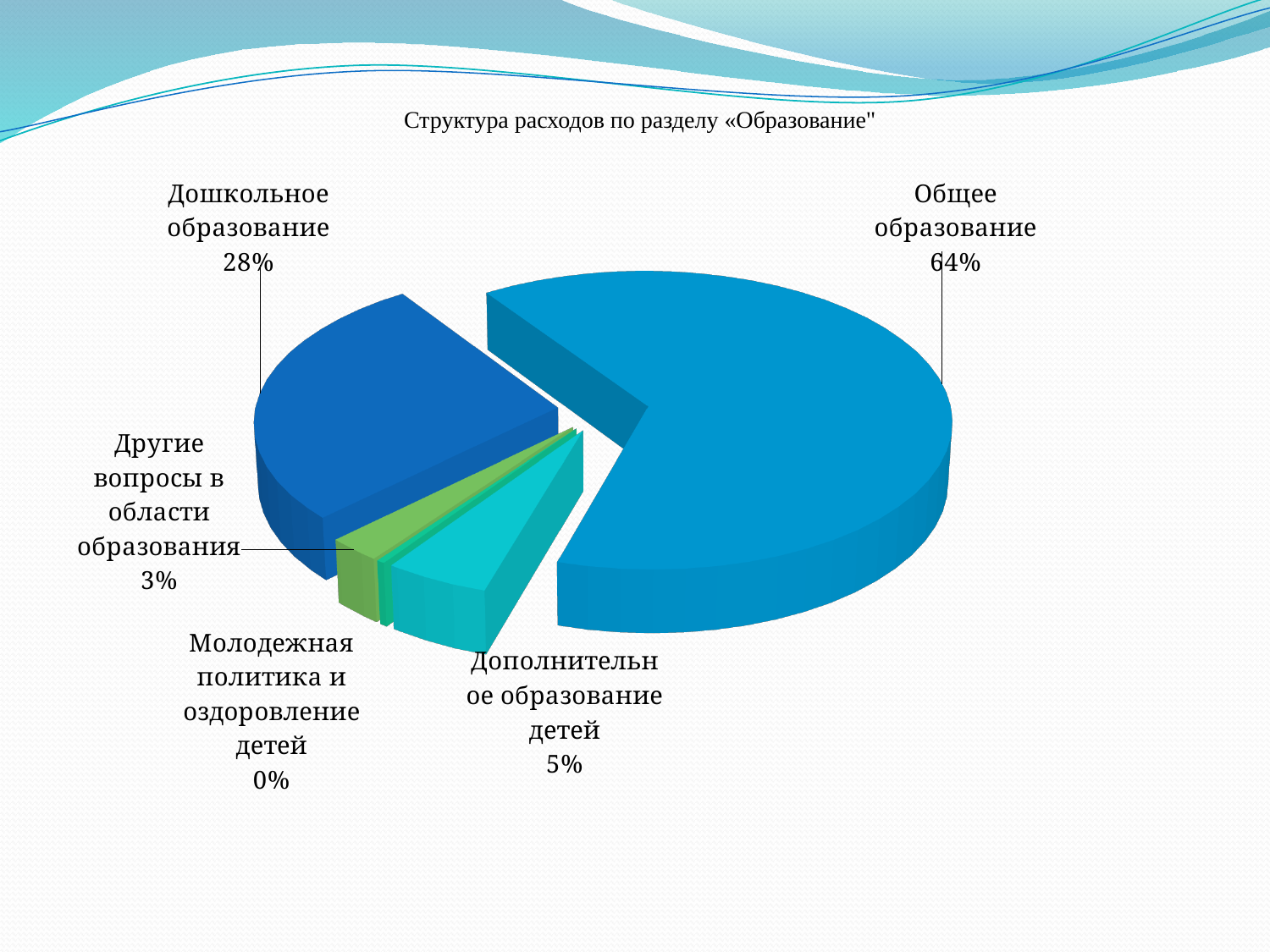
What share of expenditure goes to Общее образование? 64% What share of expenditure goes to Другие вопросы в области образования? 3% What is the difference in percentage points between Общее образование and Дошкольное образование? 36 Which category has the smallest share of the pie? Молодежная политика и оздоровление детей What share of expenditure goes to Дополнительное образование детей? 5% What share of expenditure goes to Дошкольное образование? 28% What kind of chart is shown on the slide? pie chart How many categories are shown in the pie chart? 5 Which is larger, the share for Дополнительное образование детей or the share for Другие вопросы в области образования? Дополнительное образование детей What share of expenditure goes to Молодежная политика и оздоровление детей? 0% Which category has the largest share of the pie? Общее образование What is the title of the chart? Структура расходов по разделу «Образование"